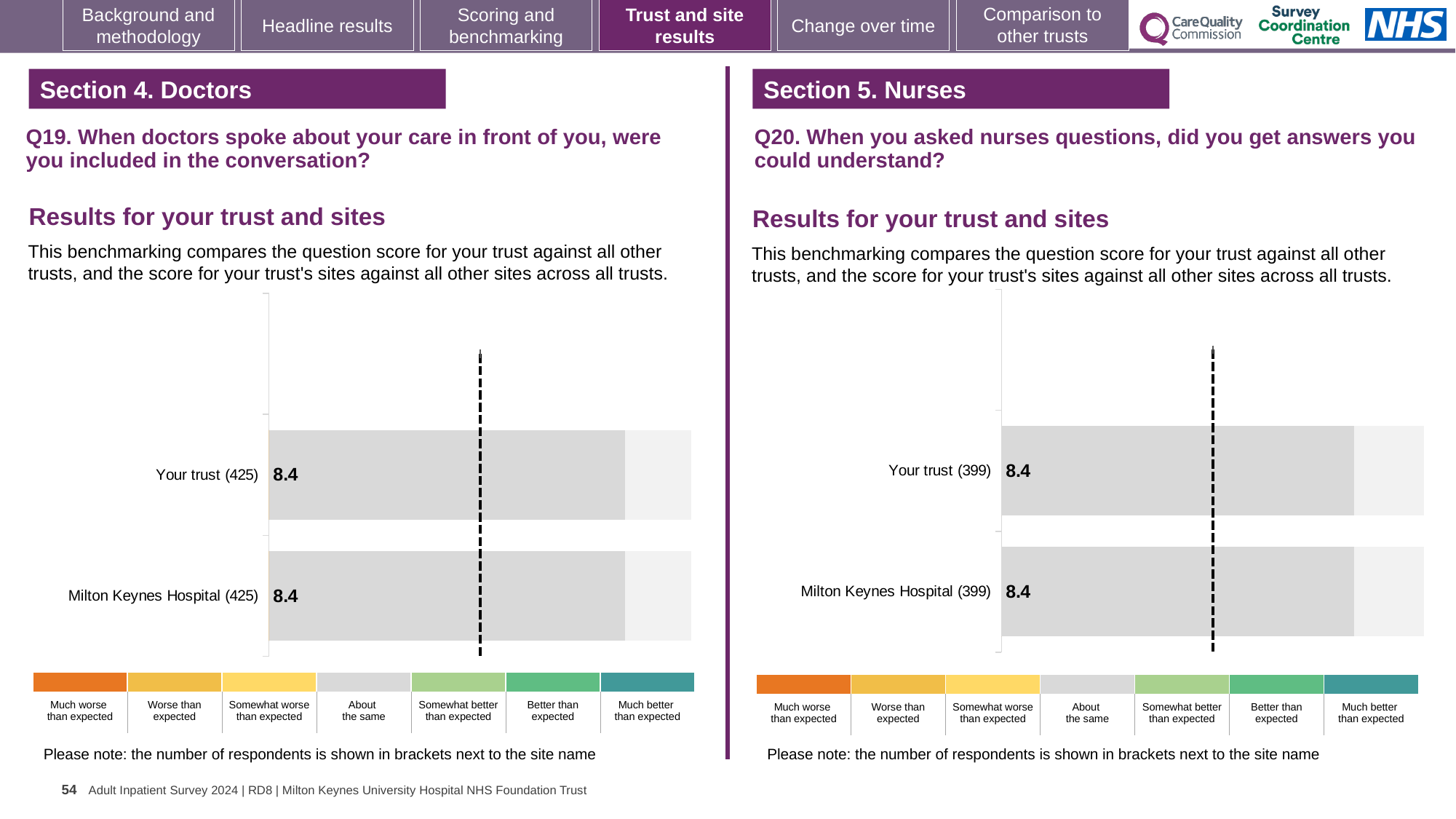
In the Q20 chart on the right, what is the score for Your trust? 8.4 In the Q20 chart on the right, how many respondents are shown in brackets next to Milton Keynes Hospital? 399 In the Q19 chart on the left, what is the score for Your trust? 8.4 How many bars are plotted in the Q19 chart on the left? 2 In the Q19 chart on the left, what is the difference between the Your trust score and the Milton Keynes Hospital score? 0 In the Q20 chart on the right, what is the score for Milton Keynes Hospital? 8.4 In the Q19 chart on the left, what is the score for Milton Keynes Hospital? 8.4 How many bars are plotted in the Q20 chart on the right? 2 In the Q19 chart on the left, how many respondents are shown in brackets next to Your trust? 425 In the Q20 chart on the right, what is the difference between the Your trust score and the Milton Keynes Hospital score? 0 What kind of chart is used for the Q19 results on the left? Bar chart